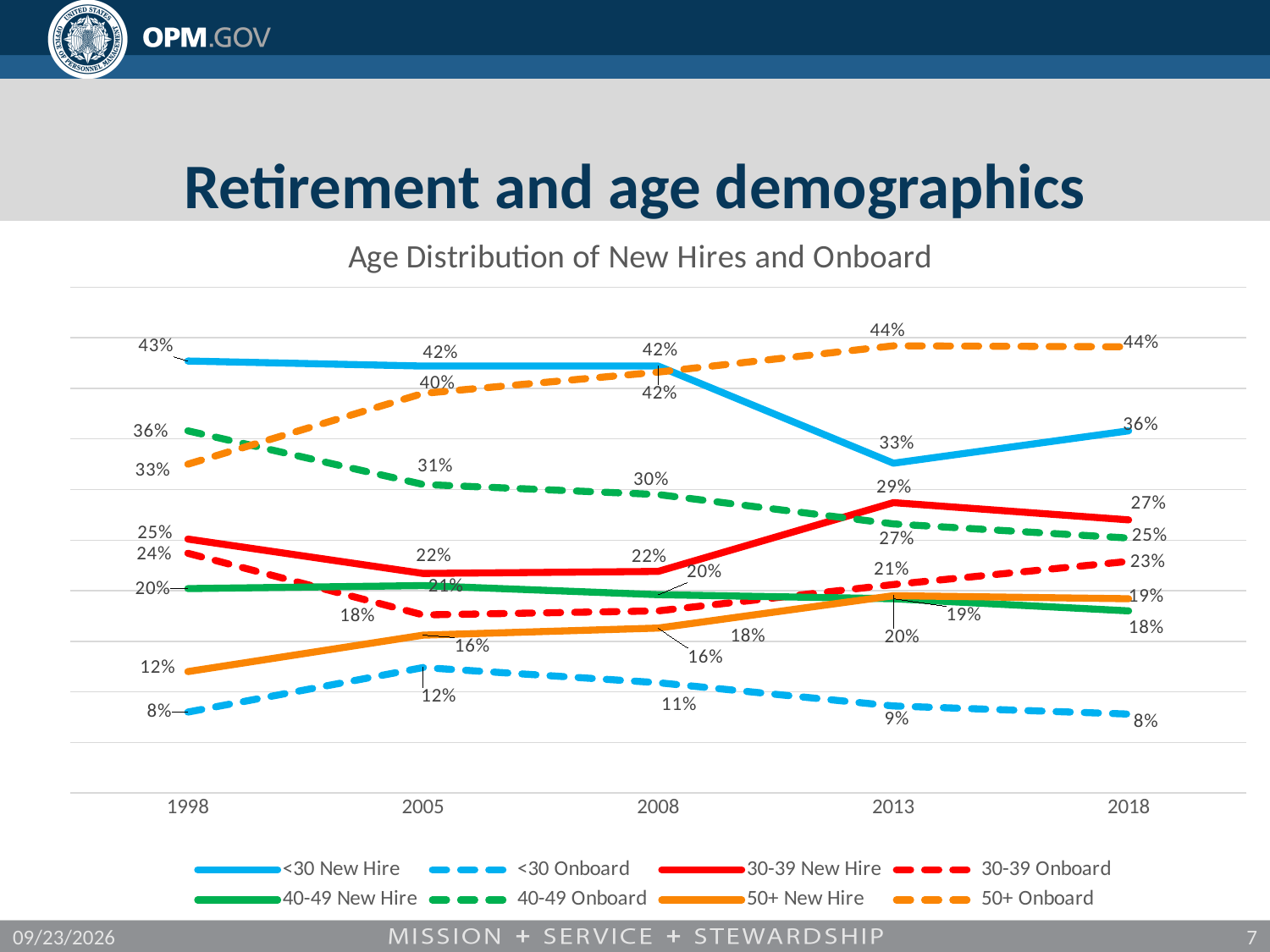
What is the value for <30 New Hire in 1998? 43% What is the value for 30-39 New Hire in 2013? 29% Does the 40-49 Onboard series rise or fall from 1998 to 2018? fall What is the value for <30 Onboard in 2013? 9% What is the difference between the <30 New Hire value in 1998 and in 2018? 7 percentage points What is the value for 50+ Onboard in 2018? 44% How many series does the legend list? 8 In 2013, which is larger: <30 New Hire or 50+ Onboard? 50+ Onboard Which series has the highest value in 2018? 50+ Onboard How many years are shown on the x axis? 5 Which series has the lowest value in 2018? <30 Onboard What kind of chart is shown on the slide? line chart